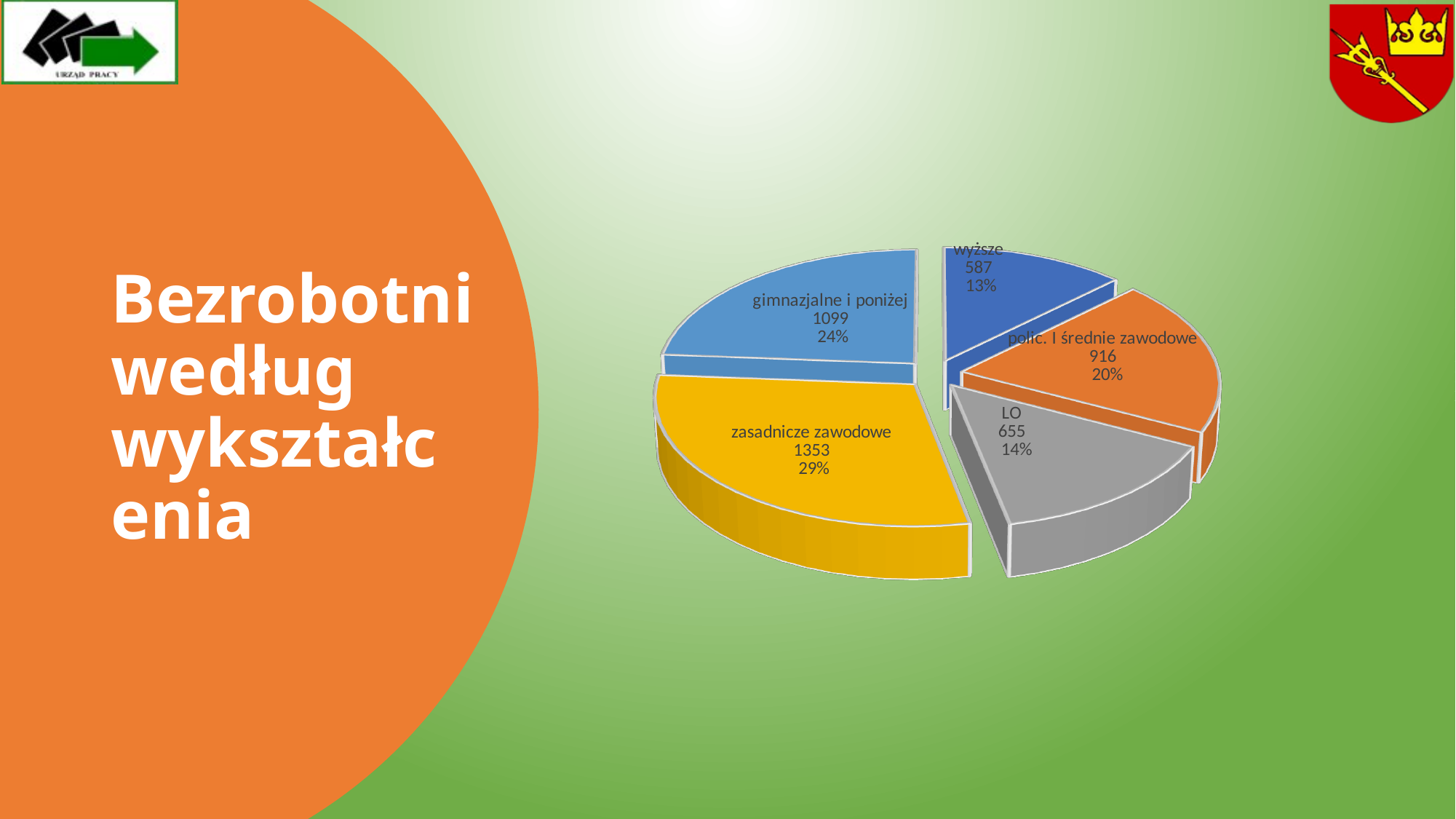
Which category has the smallest slice? wyższe What is the value for zasadnicze zawodowe? 1353 Which category has the largest slice? zasadnicze zawodowe What is the value for wyższe? 587 What percentage share does gimnazjalne i poniżej have? 24% What percentage share does polic. I średnie zawodowe have? 20% Which is larger, the value for polic. I średnie zawodowe or the value for LO? polic. I średnie zawodowe How many slices does the pie chart have? 5 What is the value for LO? 655 What is the difference between the values for zasadnicze zawodowe and gimnazjalne i poniżej? 254 What colour is the slice for zasadnicze zawodowe? yellow What kind of chart is shown on the slide? pie chart